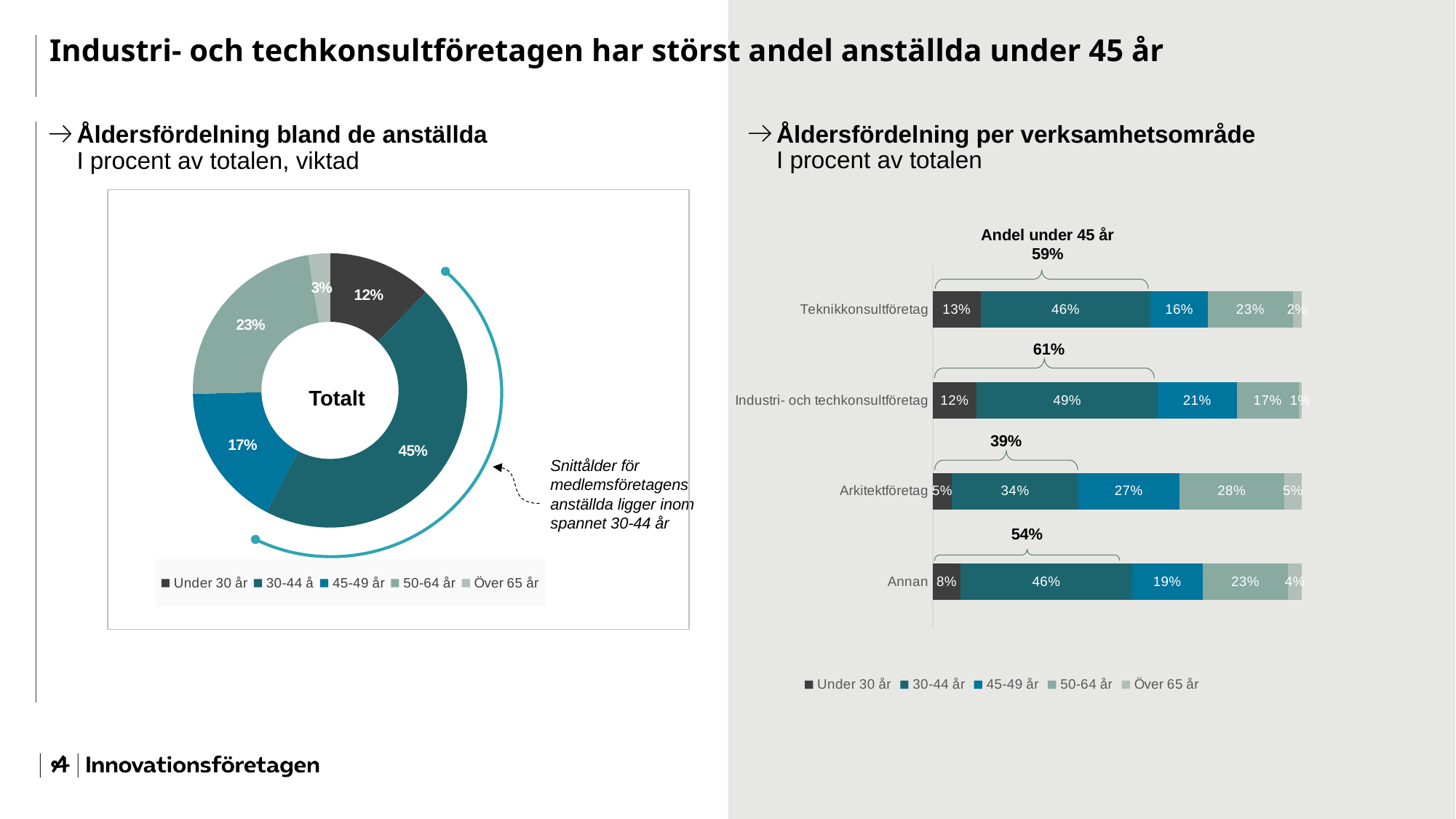
In the left chart (Åldersfördelning bland de anställda), which age group has the largest share? 30-44 år In the right chart (Åldersfördelning per verksamhetsområde), which business area has the highest Andel under 45 år? Industri- och techkonsultföretag In the right chart (Åldersfördelning per verksamhetsområde), what is the 45-49 år share for Arkitektföretag? 27% In the left chart (Åldersfördelning bland de anställda), what share of employees are Över 65 år? 3% In the left chart (Åldersfördelning bland de anställda), which age group has the smallest share? Över 65 år In the right chart (Åldersfördelning per verksamhetsområde), how many business areas are shown? 4 In the left chart (Åldersfördelning bland de anställda), what is the difference between the 50-64 år share and the 45-49 år share? 6% In the right chart (Åldersfördelning per verksamhetsområde), which business area has the lowest Andel under 45 år? Arkitektföretag In the left chart (Åldersfördelning bland de anställda), what share of employees are in the 30-44 år group? 45% How many series does the legend of the right chart (Åldersfördelning per verksamhetsområde) list? 5 What kind of chart is the left chart (Åldersfördelning bland de anställda)? Donut (pie) chart In the right chart (Åldersfördelning per verksamhetsområde), what is the 30-44 år share for Industri- och techkonsultföretag? 49%